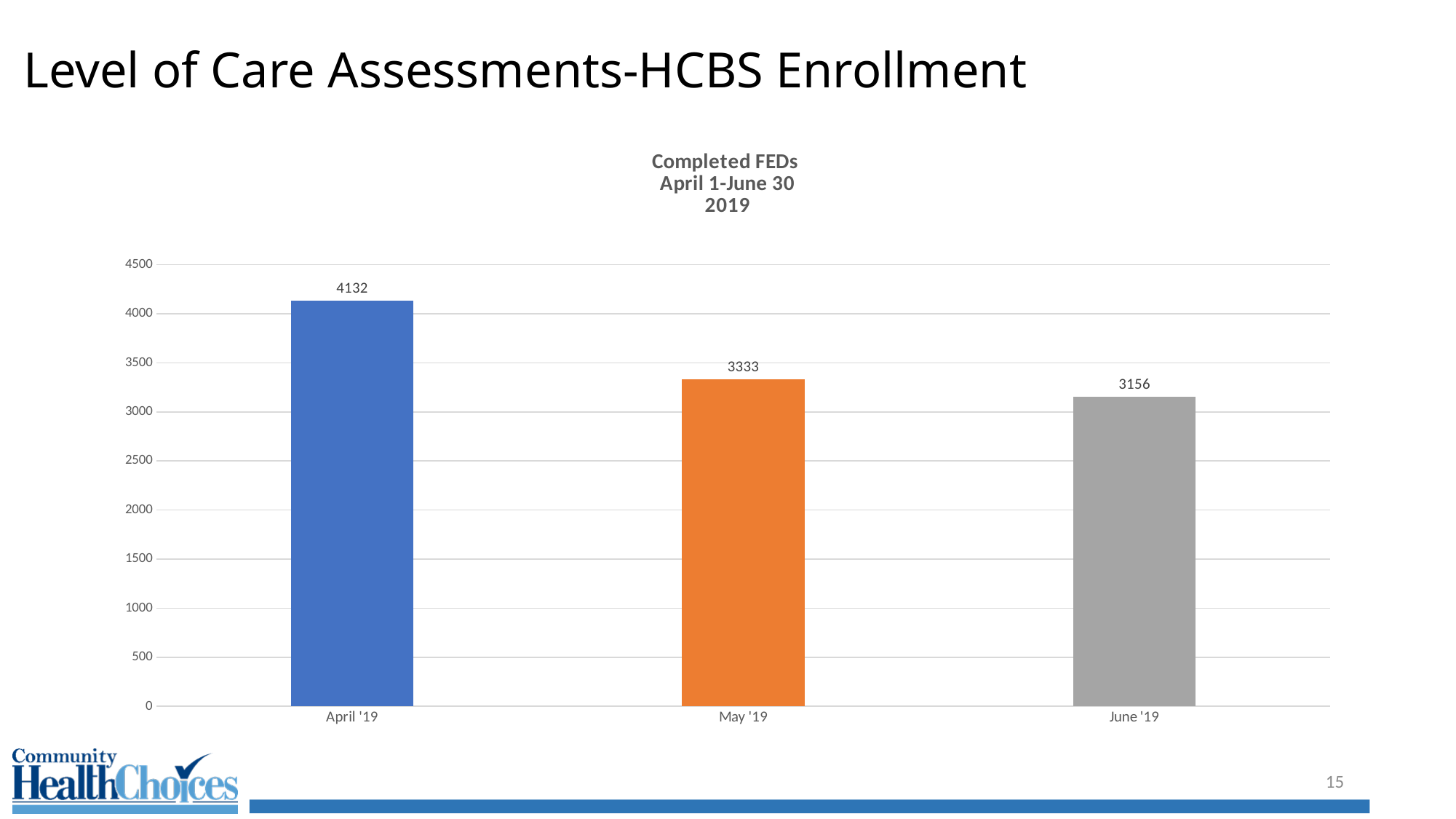
What is the value for June '19? 3156 Is the value for June '19 greater or less than 3500? less Which is larger, the value for April '19 or the value for June '19? April '19 What is the value for April '19? 4132 Do the values rise or fall from April '19 to June '19? fall What is the difference between the values for April '19 and May '19? 799 What is the value for May '19? 3333 Which month has the highest number of completed FEDs? April '19 How many months are shown on the chart? 3 Which month has the lowest number of completed FEDs? June '19 What kind of chart is shown on the slide? bar chart What is the difference between the values for May '19 and June '19? 177